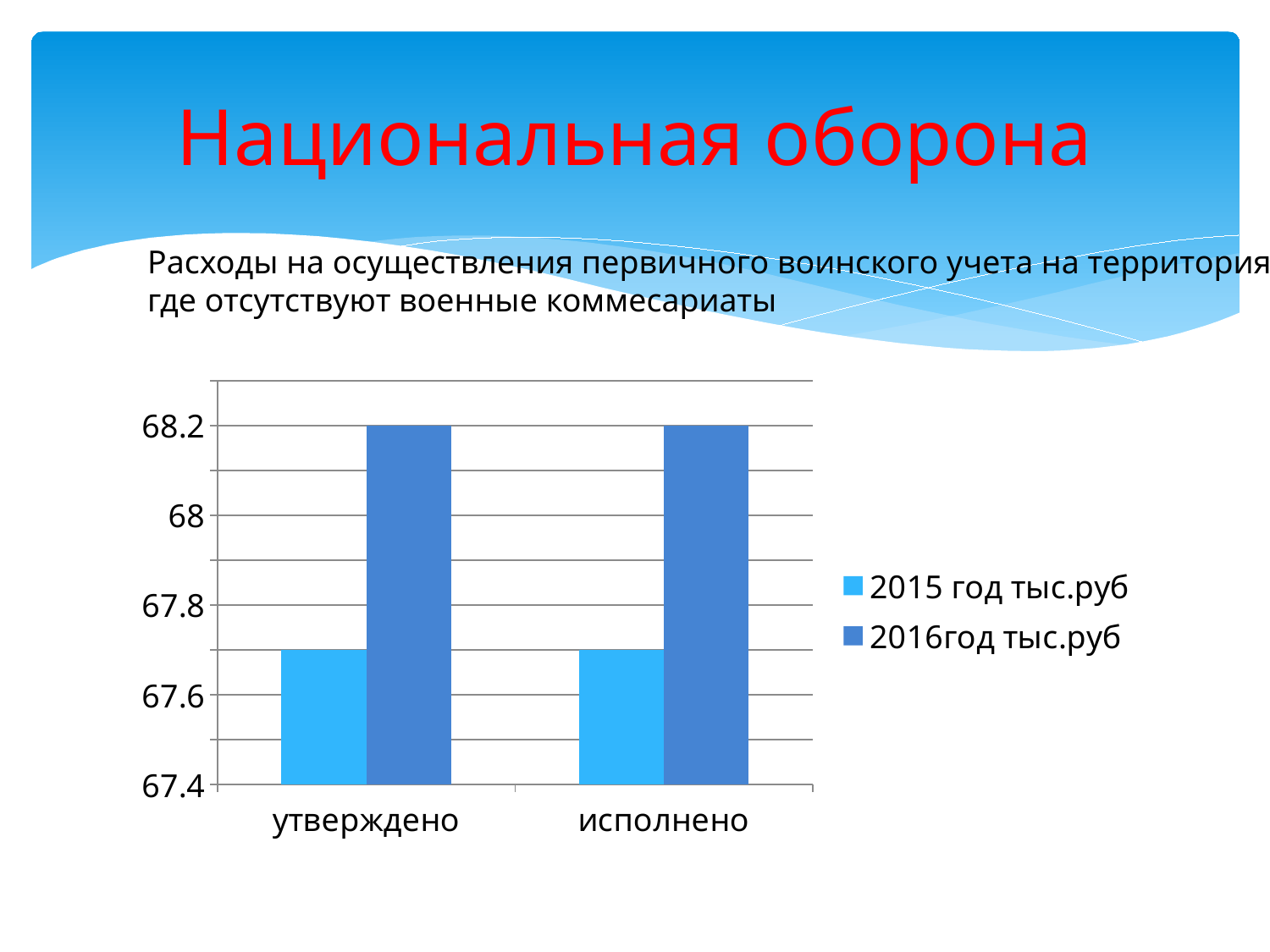
Is the value for 2015 год тыс.руб in the утверждено category greater or less than 67.6? greater Is the value for 2016год тыс.руб in the утверждено category greater or less than 68? greater What is the value for 2016год тыс.руб in the утверждено category? 68.2 How many series does the chart legend list? 2 In the утверждено category, which series has the larger value, 2015 год тыс.руб or 2016год тыс.руб? 2016год тыс.руб What kind of chart is shown on the slide? bar chart How many categories are shown on the x axis of the chart? 2 What are the two entries listed in the chart legend? 2015 год тыс.руб and 2016год тыс.руб Is the value for 2015 год тыс.руб in the исполнено category greater or less than 67.8? less Do the values for 2016год тыс.руб rise, fall or stay the same from утверждено to исполнено? stay the same What is the value for 2016год тыс.руб in the исполнено category? 68.2 Which series has the lowest values in the chart? 2015 год тыс.руб